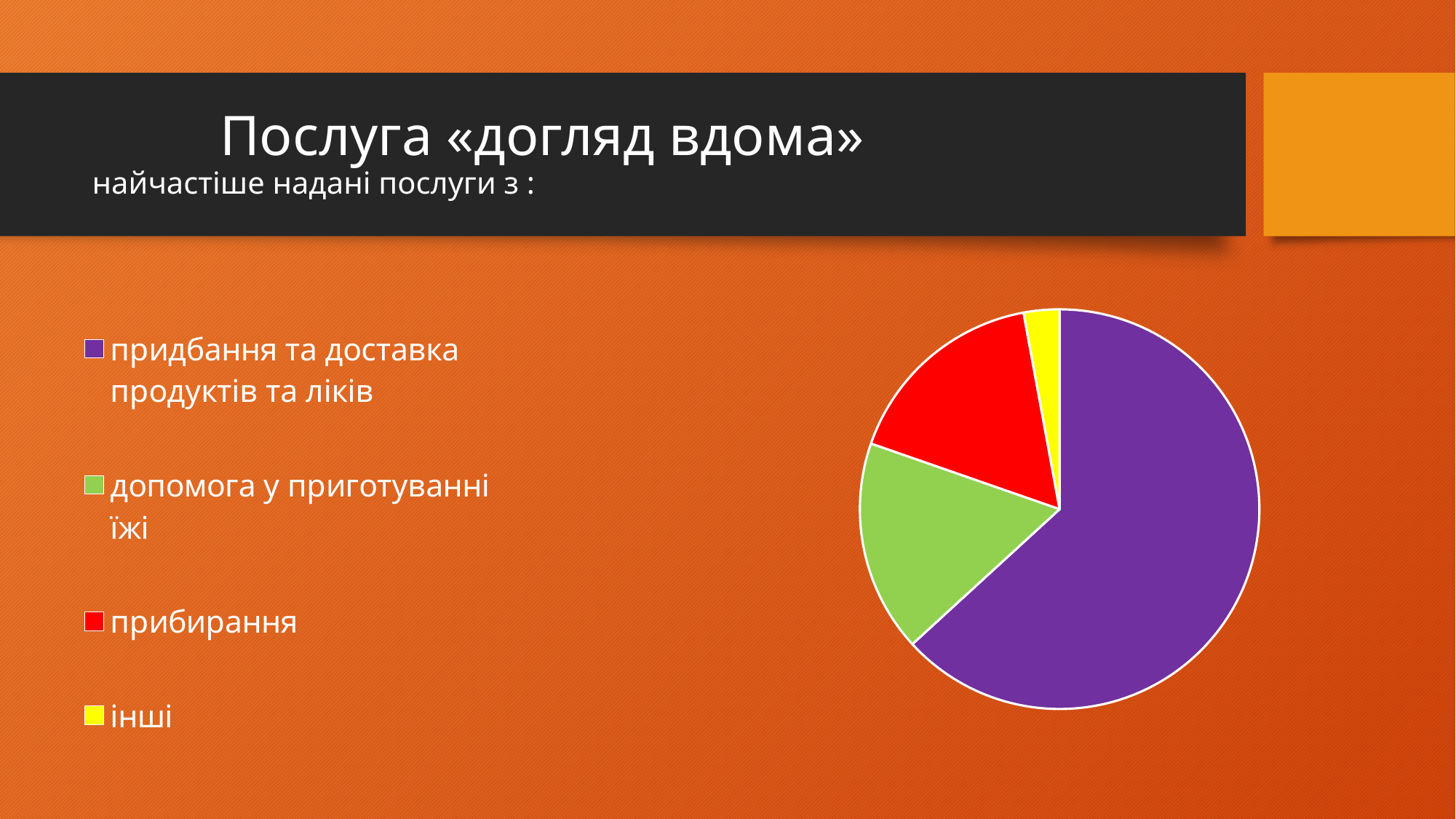
What kind of chart is shown on the slide? pie chart Which category has the smallest slice in the pie chart? інші How many entries does the legend of the pie chart list? 4 Which slice is larger: допомога у приготуванні їжі or інші? допомога у приготуванні їжі Which category has the largest slice in the pie chart? придбання та доставка продуктів та ліків How many slices does the pie chart have? 4 Which category is shown in purple in the pie chart? придбання та доставка продуктів та ліків Which slice is larger: придбання та доставка продуктів та ліків or допомога у приготуванні їжі? придбання та доставка продуктів та ліків Which slice is larger: прибирання or інші? прибирання What colour is the slice for прибирання in the pie chart? red